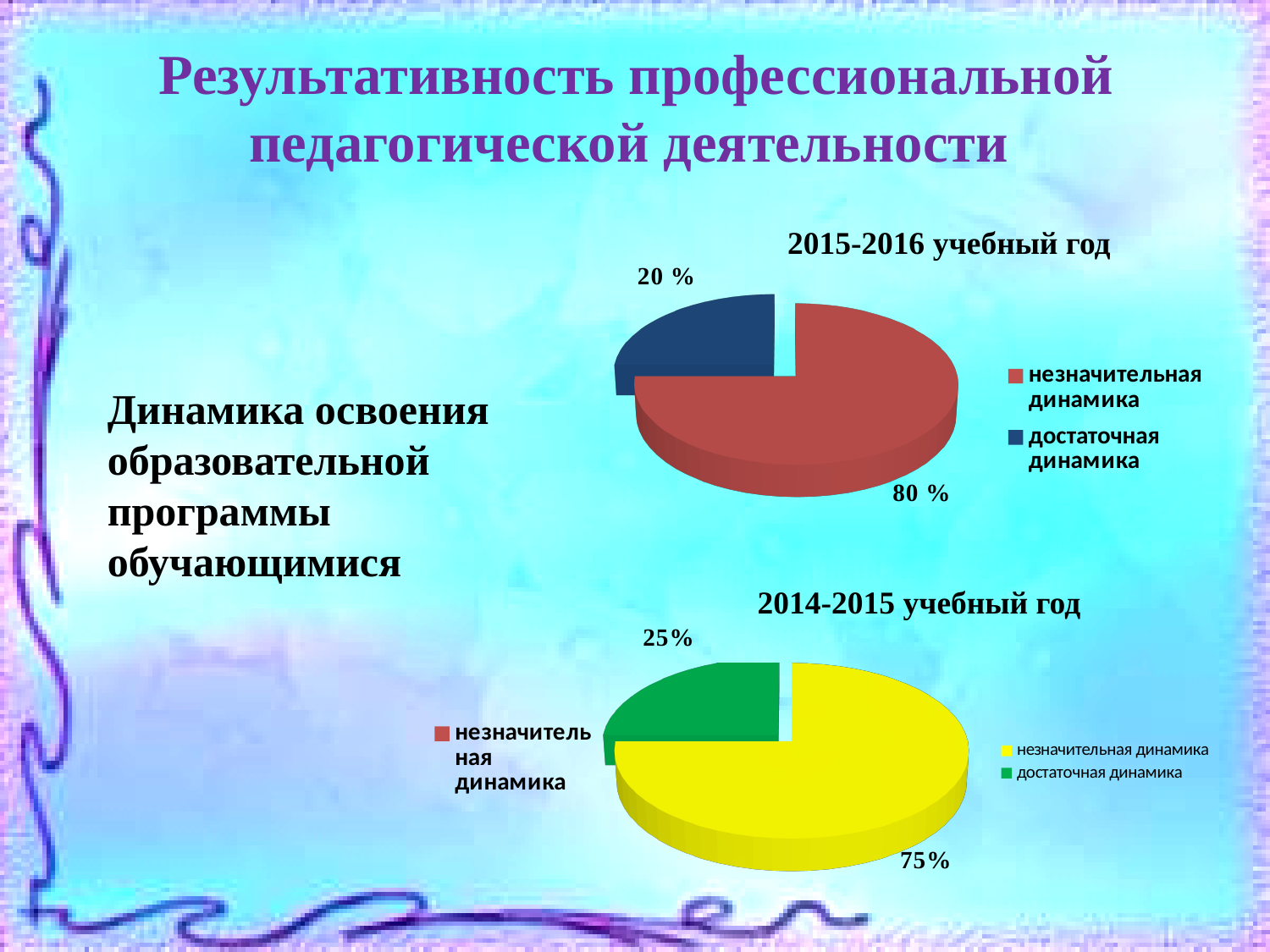
In the 2014-2015 учебный год chart, what is the difference between the незначительная динамика and достаточная динамика shares? 50% In the 2015-2016 учебный год chart, which category has the largest slice? незначительная динамика What type of chart is used for the 2015-2016 учебный год data? pie chart In the 2015-2016 учебный год chart, what is the difference between the незначительная динамика and достаточная динамика shares? 60 % How many slices does the 2014-2015 учебный год pie chart have? 2 In the 2015-2016 учебный год chart, what share is labelled for достаточная динамика? 20 % In the 2015-2016 учебный год chart, what share is labelled for незначительная динамика? 80 % In the 2014-2015 учебный год chart, what share is labelled for незначительная динамика? 75% In the 2014-2015 учебный год chart, which category has the smallest slice? достаточная динамика In the 2014-2015 учебный год chart, what share is labelled for достаточная динамика? 25% In the 2015-2016 учебный год chart, what colour is the slice for достаточная динамика? blue Which is larger: the достаточная динамика share in the 2014-2015 учебный год chart or in the 2015-2016 учебный год chart? 2014-2015 учебный год